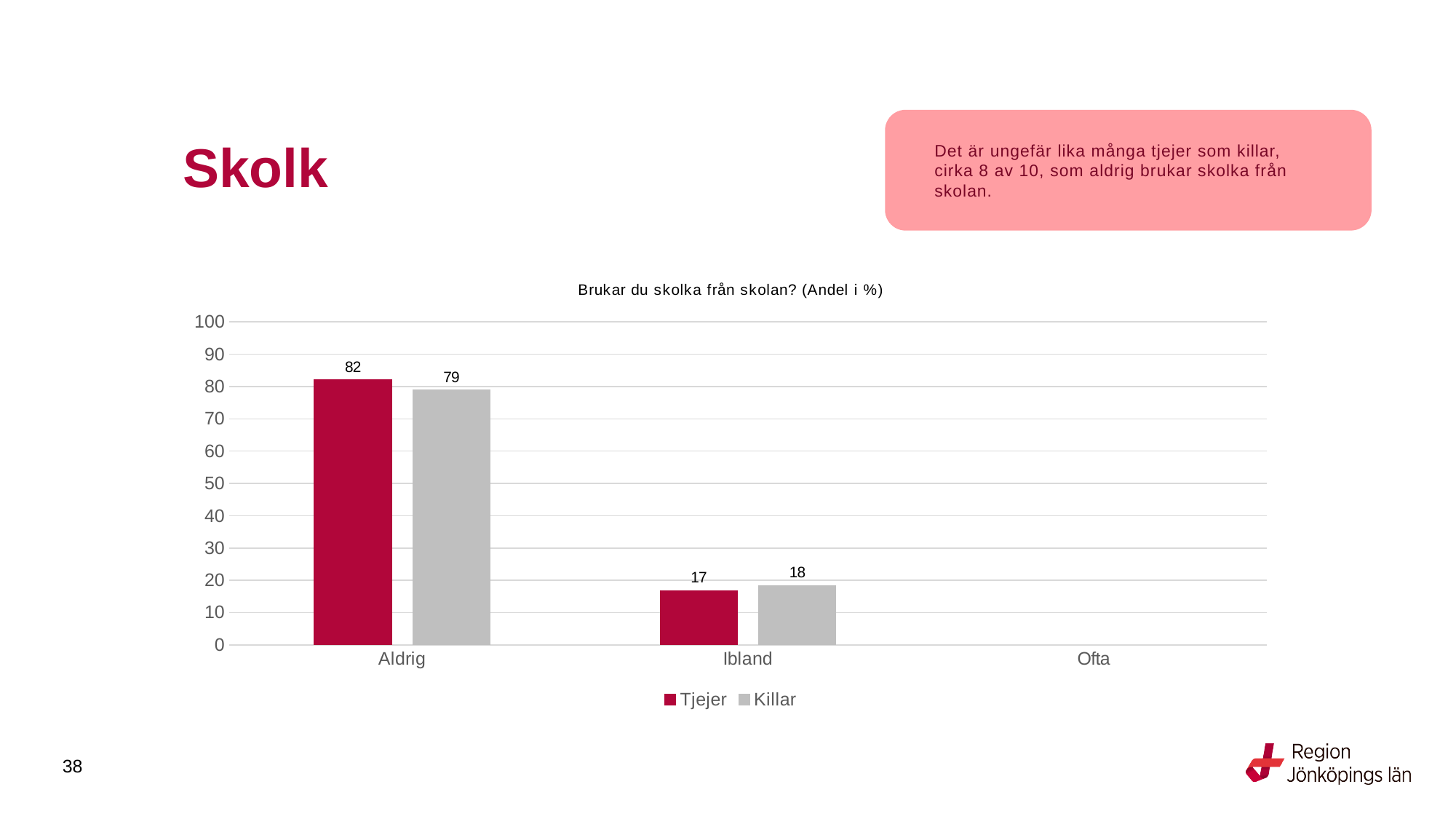
What is the title of the chart? Brukar du skolka från skolan? (Andel i %) What is the difference between the Tjejer and Killar values in the Aldrig category? 3 What is the value for Killar in the Aldrig category? 79 What is the value for Tjejer in the Ibland category? 17 What is the value for Killar in the Ibland category? 18 How many series does the legend list? 2 Which category has the highest value for Tjejer? Aldrig What kind of chart is shown on the slide? Bar chart What is the difference between the Tjejer values for Aldrig and Ibland? 65 How many categories are shown on the x axis? 3 What is the value for Tjejer in the Aldrig category? 82 Which is larger in the Aldrig category, Tjejer or Killar? Tjejer